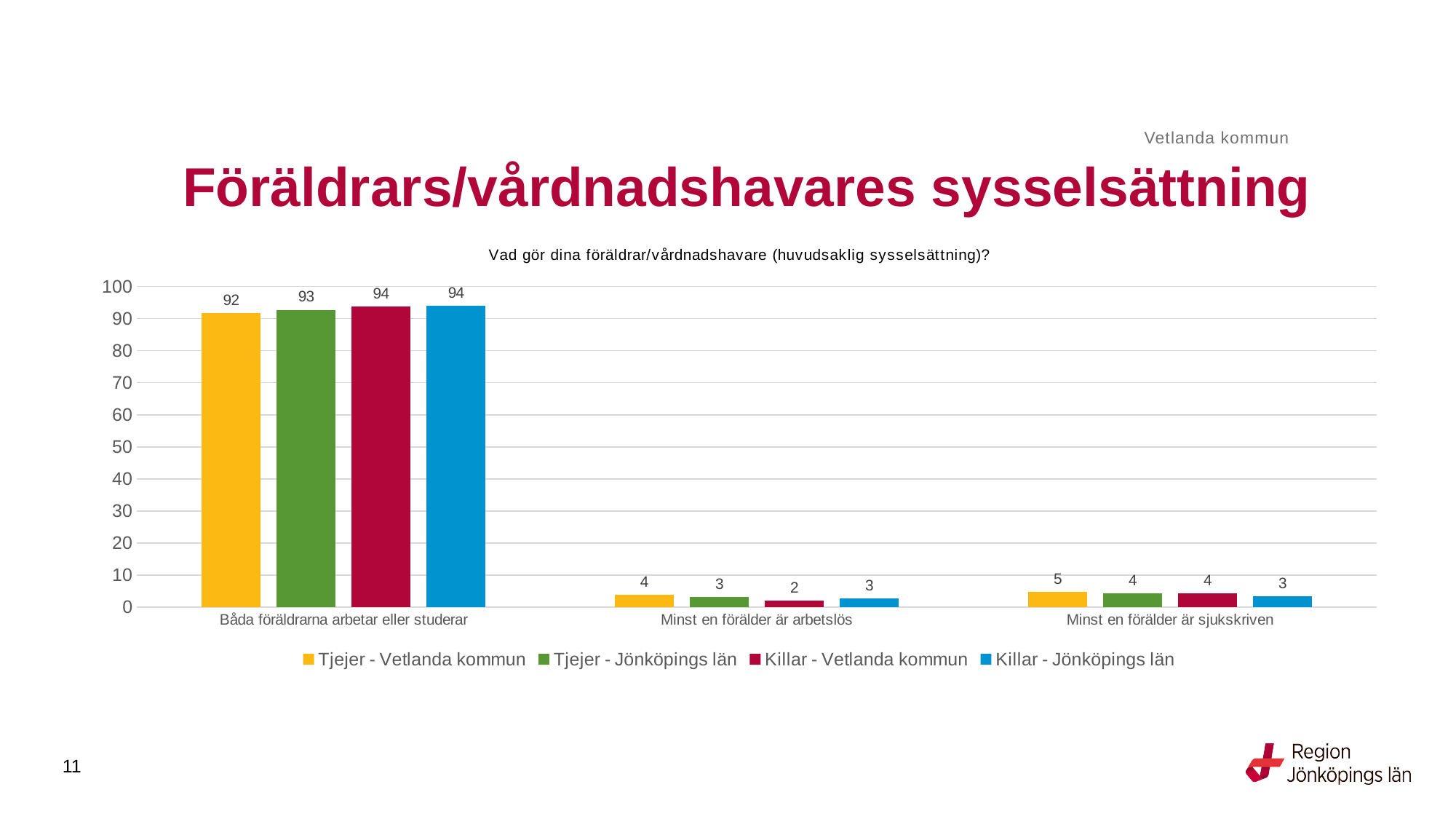
What is the value for Killar - Jönköpings län in the category 'Båda föräldrarna arbetar eller studerar'? 94 What question is shown as the chart's subtitle? Vad gör dina föräldrar/vårdnadshavare (huvudsaklig sysselsättning)? Which category has the highest values across all series? Båda föräldrarna arbetar eller studerar In the category 'Minst en förälder är sjukskriven', which is larger: Tjejer - Vetlanda kommun or Killar - Jönköpings län? Tjejer - Vetlanda kommun Which series has the lowest value in the category 'Minst en förälder är arbetslös'? Killar - Vetlanda kommun How many series does the legend list? 4 What is the value for Tjejer - Vetlanda kommun in the category 'Båda föräldrarna arbetar eller studerar'? 92 What is the value for Tjejer - Vetlanda kommun in the category 'Minst en förälder är sjukskriven'? 5 What is the difference between Killar - Vetlanda kommun and Tjejer - Vetlanda kommun in the category 'Båda föräldrarna arbetar eller studerar'? 2 What kind of chart is shown on the slide? Bar chart How many categories are shown on the x axis? 3 What is the value for Killar - Vetlanda kommun in the category 'Minst en förälder är arbetslös'? 2